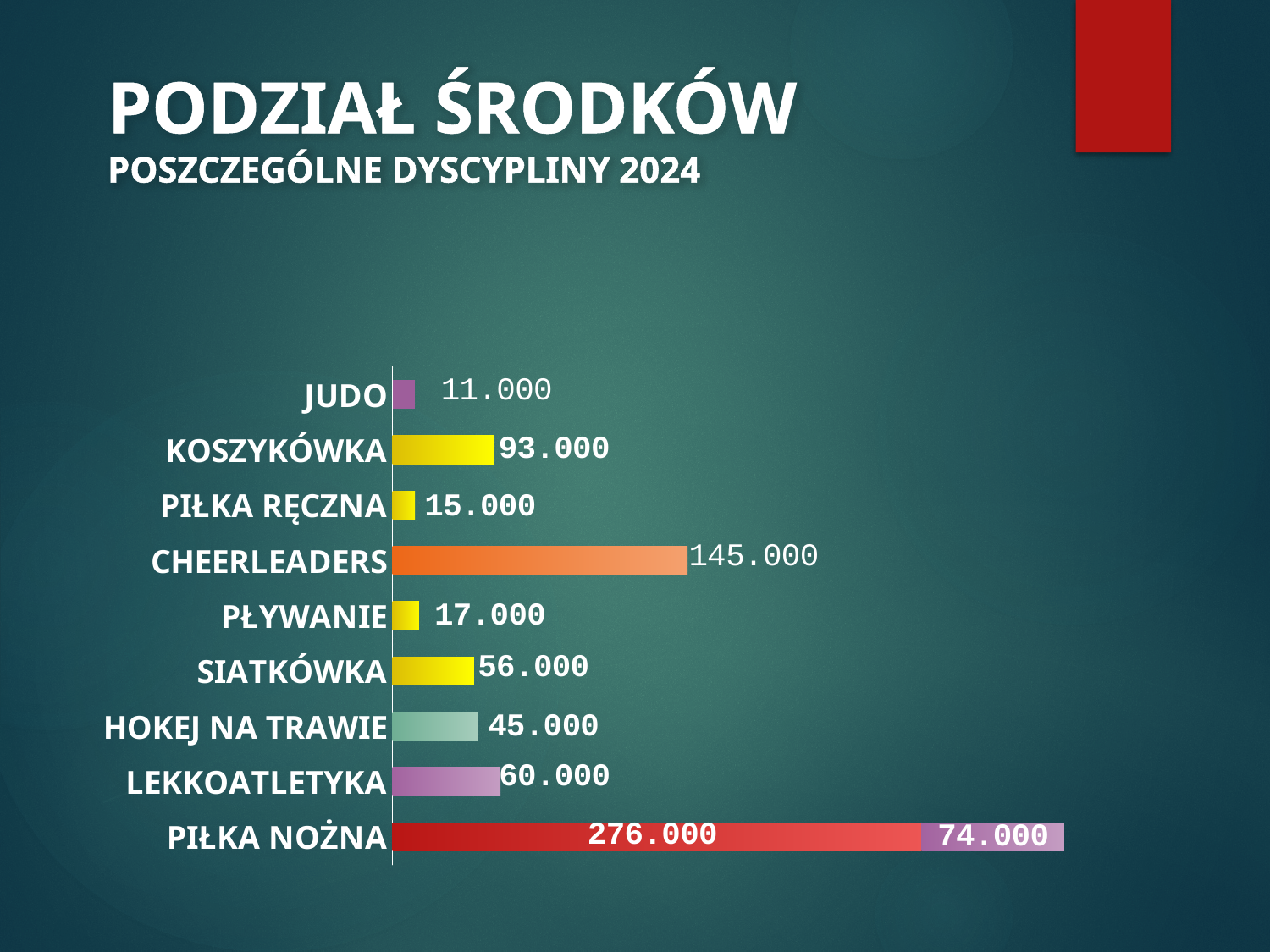
What kind of chart is shown on the slide? Bar chart Which category has the lowest value? JUDO What value is shown for KOSZYKÓWKA? 93.000 What is the difference between the values for KOSZYKÓWKA and SIATKÓWKA? 37.000 What is the difference between the values for LEKKOATLETYKA and HOKEJ NA TRAWIE? 15.000 Which is larger, the value for PŁYWANIE or the value for PIŁKA RĘCZNA? PŁYWANIE What is the total of the two segments of the PIŁKA NOŻNA bar? 350.000 What value is shown for HOKEJ NA TRAWIE? 45.000 Which category has the longest bar overall? PIŁKA NOŻNA What is the first (red) segment value shown for PIŁKA NOŻNA? 276.000 What value is shown for CHEERLEADERS? 145.000 How many categories are shown in the chart? 9